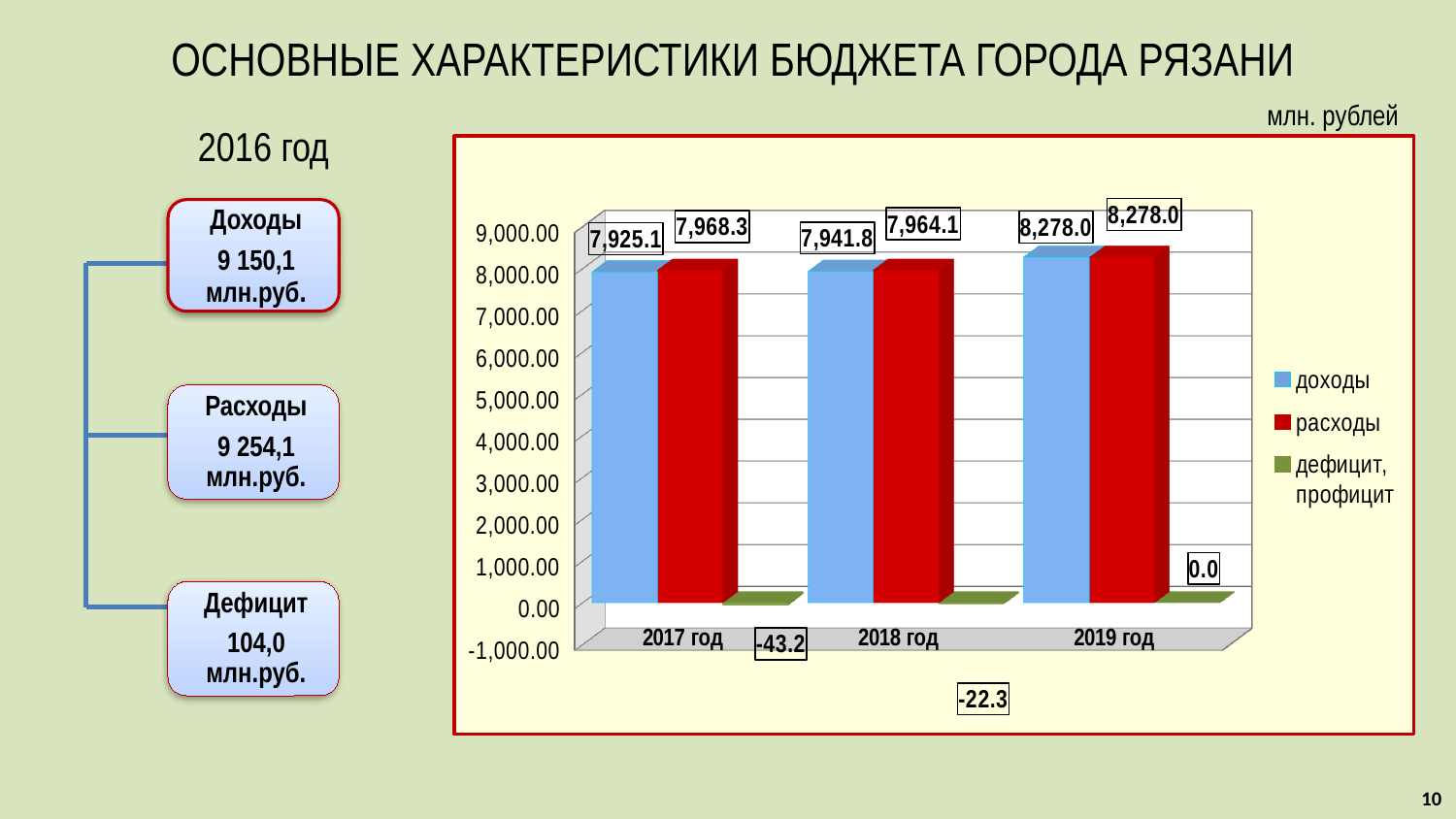
What is the value of дефицит, профицит for 2017 год? -43.2 Do the values of доходы rise or fall from 2017 год to 2019 год? rise Which is larger for 2018 год: доходы or расходы? расходы How many series does the chart legend list? 3 What is the difference between расходы and доходы for 2017 год? 43.2 How many years are shown on the x axis of the chart? 3 What kind of chart is shown on the slide? bar chart What is the value of расходы for 2018 год? 7,964.1 Which year has the highest value of доходы? 2019 год What is the value of доходы for 2017 год? 7,925.1 Which year has the lowest value of дефицит, профицит? 2017 год What is the value of дефицит, профицит for 2019 год? 0.0